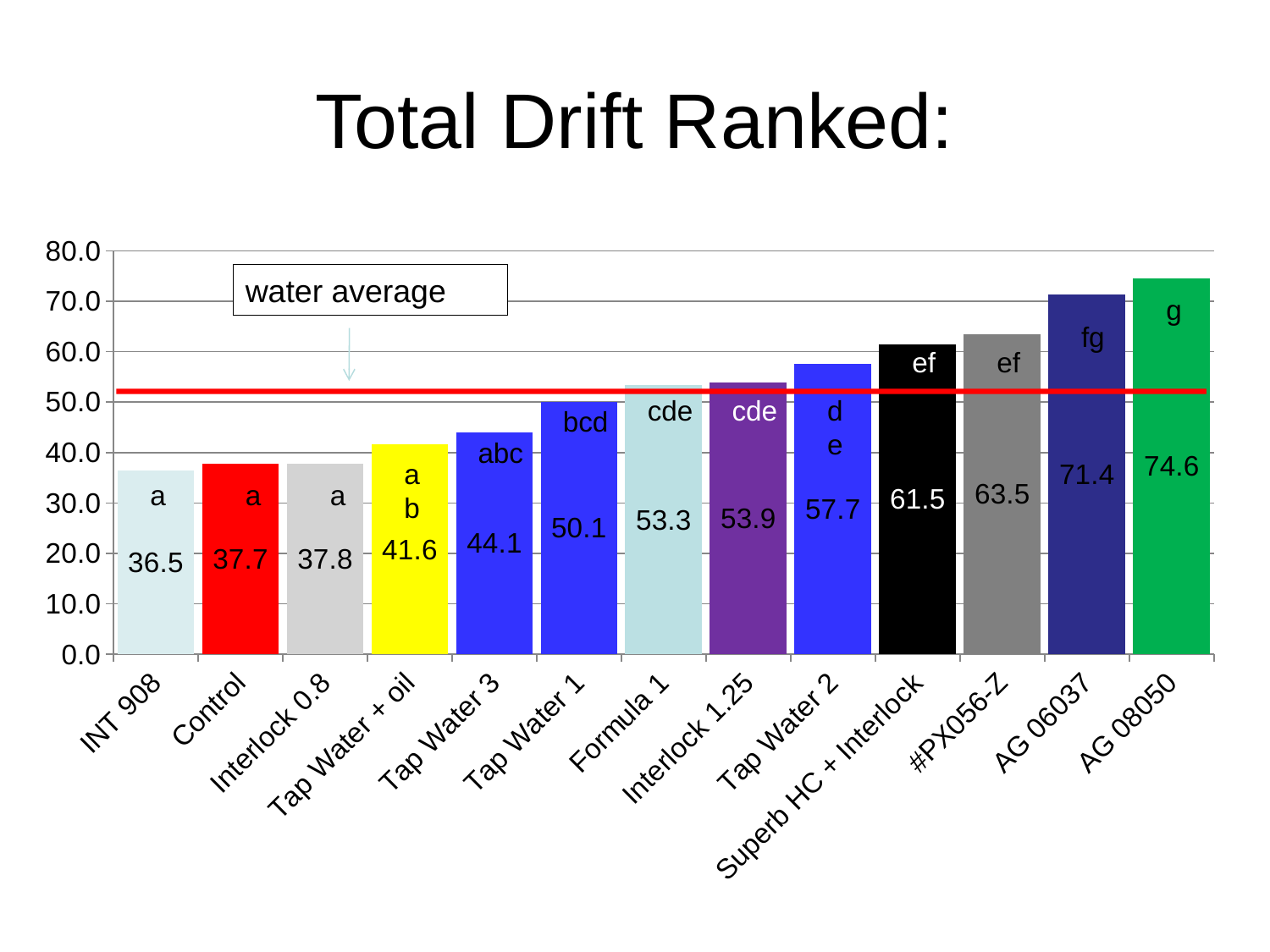
Do the values rise or fall from left to right along the x axis? rise What does the red horizontal line represent? water average Which category has the highest value? AG 08050 Is the value for AG 06037 greater or less than 70.0? greater What kind of chart is this? bar chart How many categories are shown on the x axis? 13 What is the value for Superb HC + Interlock? 61.5 What is the difference between the values for AG 08050 and INT 908? 38.1 Which is larger, the value for Tap Water 2 or the value for Formula 1? Tap Water 2 What is the value for Tap Water 1? 50.1 What is the value for Control? 37.7 Which category has the lowest value? INT 908